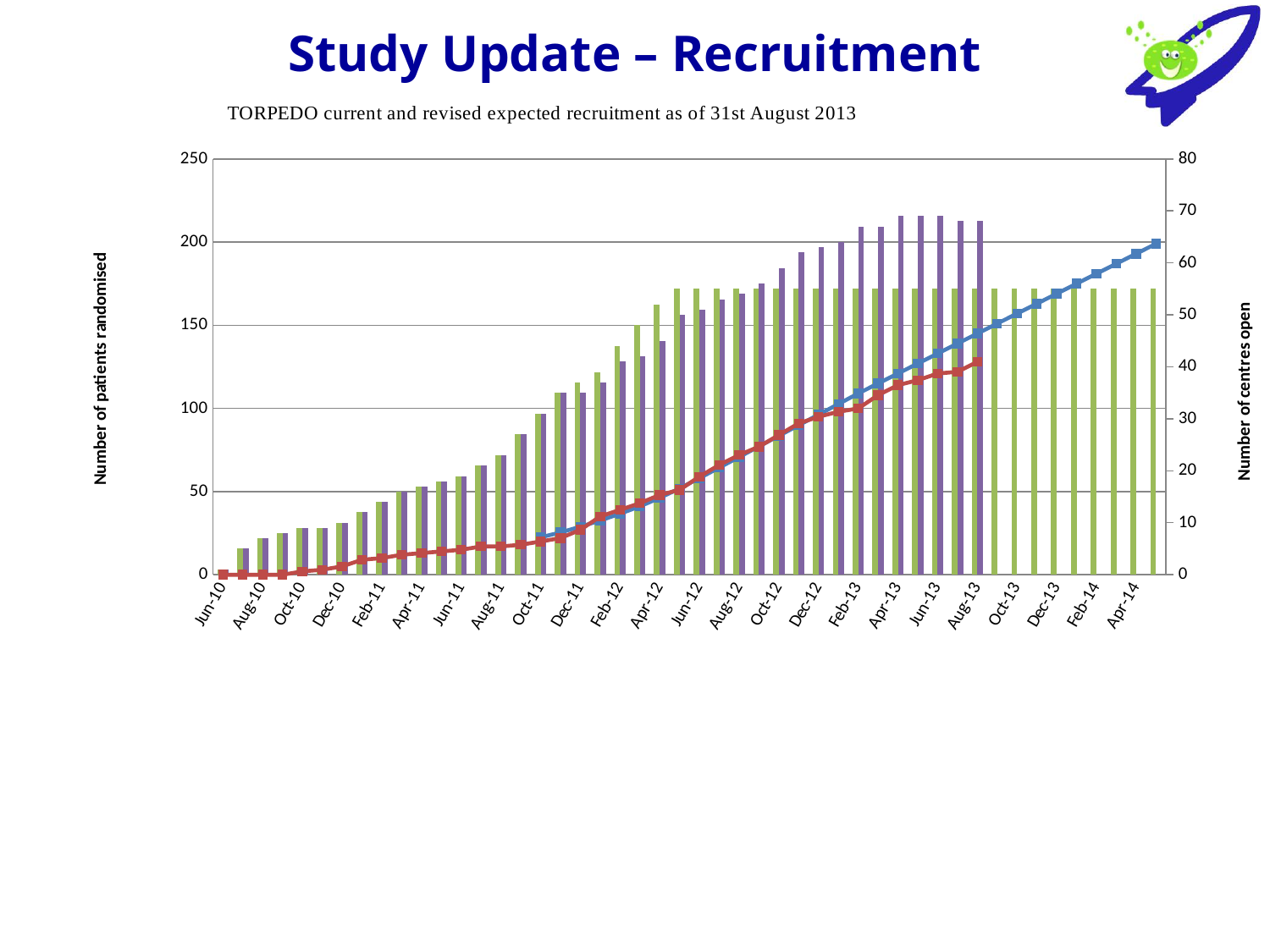
At Apr-13, which bar is taller, the purple bar or the green bar? the purple bar Does the blue line rise or fall from Jun-10 to Apr-14? rise What is the maximum value shown on the right vertical axis? 80 What kind of chart is shown on the slide? Combined bar and line chart What is the last month label on the x axis? Apr-14 What is the title of the chart? TORPEDO current and revised expected recruitment as of 31st August 2013 Is the value of the red line at Dec-11 greater or less than 50 on the left axis? less At Aug-13, which line is higher, the blue line or the red line? the blue line What is the first month label on the x axis? Jun-10 What is the maximum value shown on the left vertical axis? 250 What is the label of the left vertical axis? Number of patients randomised Is the value of the red line at Aug-13 greater or less than 100 on the left axis? greater